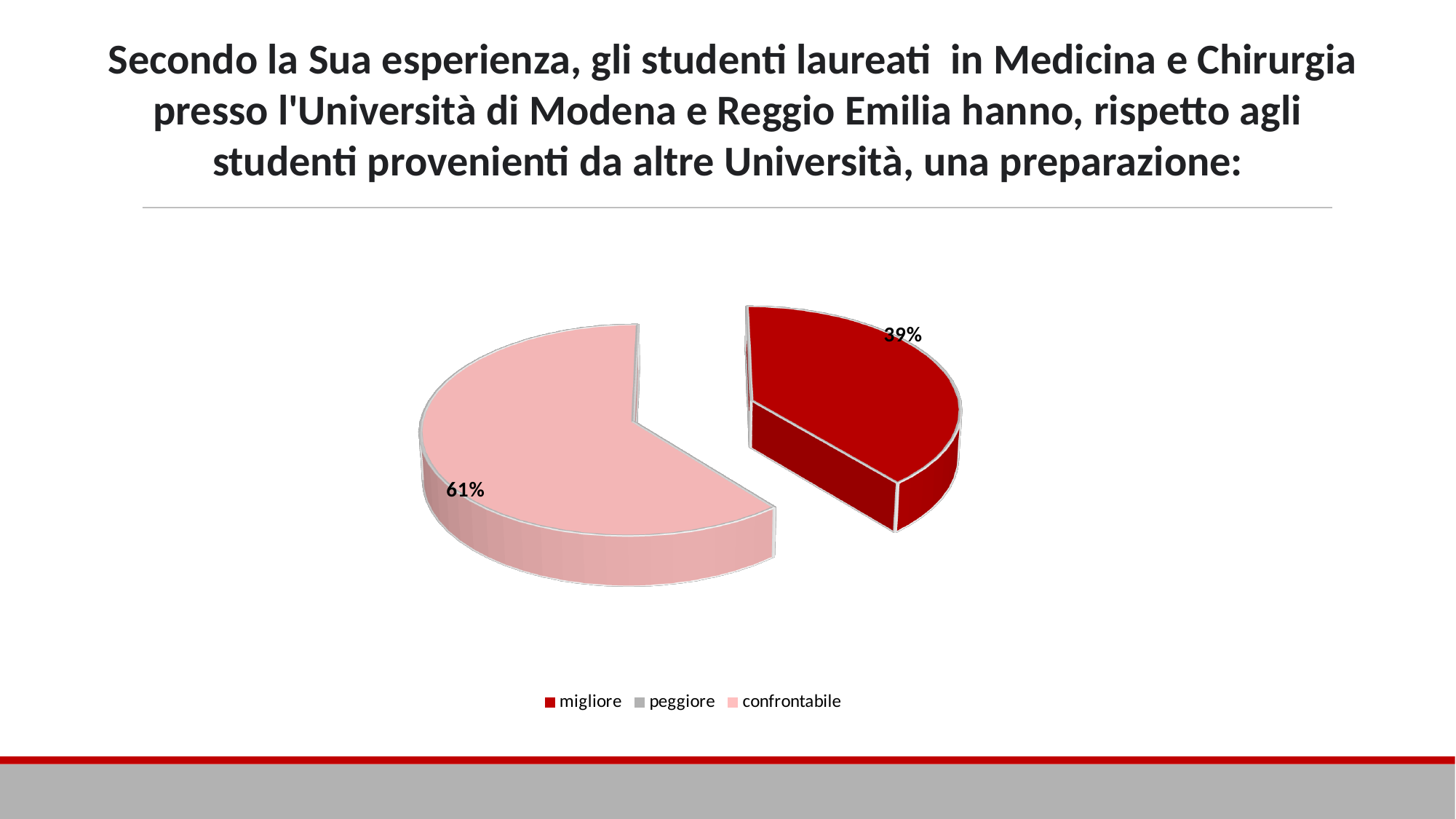
What percentage of the pie is labelled for "confrontabile"? 61% Which category has the largest slice of the pie? confrontabile What kind of chart is shown on the slide? pie chart How many slices are visible in the pie chart? 2 What is the difference in percentage points between the "confrontabile" slice and the "migliore" slice? 22 Which of the two visible slices is smaller, "migliore" or "confrontabile"? migliore How many entries does the legend list? 3 Which legend entry has no visible slice in the pie? peggiore What colour is the slice for "migliore"? dark red What percentage of the pie is labelled for "migliore"? 39% Which is larger, the slice for "migliore" or the slice for "confrontabile"? confrontabile